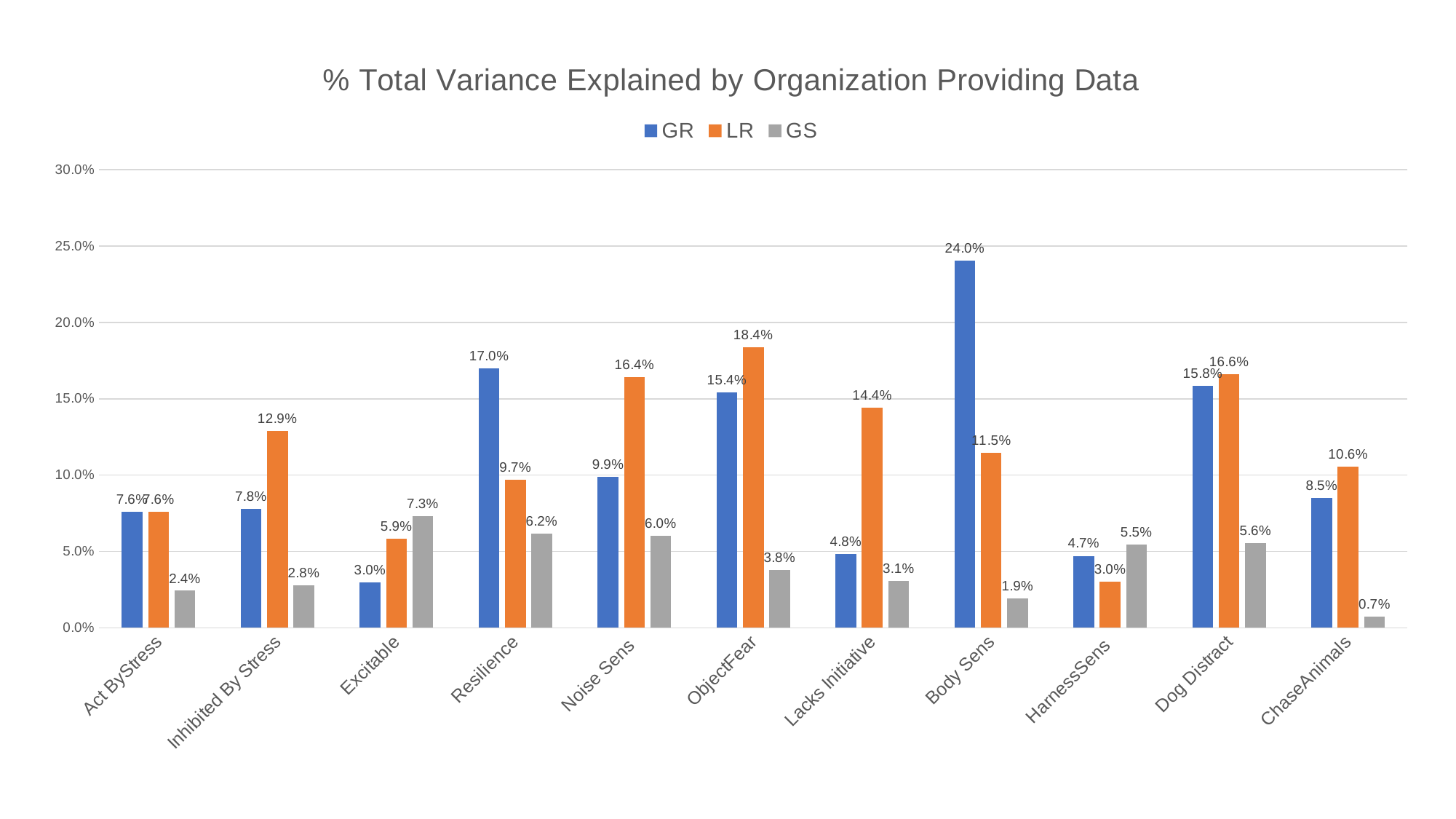
What kind of chart is this? Bar chart Which category has the lowest GS value? ChaseAnimals What is the GR value for Body Sens? 24.0% Which category has the highest GR value? Body Sens For Resilience, which is larger, the GR value or the LR value? GR What is the LR value for ObjectFear? 18.4% What is the GS value for ChaseAnimals? 0.7% What is the title of the chart? % Total Variance Explained by Organization Providing Data Which category has the highest LR value? ObjectFear How many categories are shown on the x axis? 11 What is the difference between the LR and GR values for Lacks Initiative? 9.6% How many series does the legend list? 3